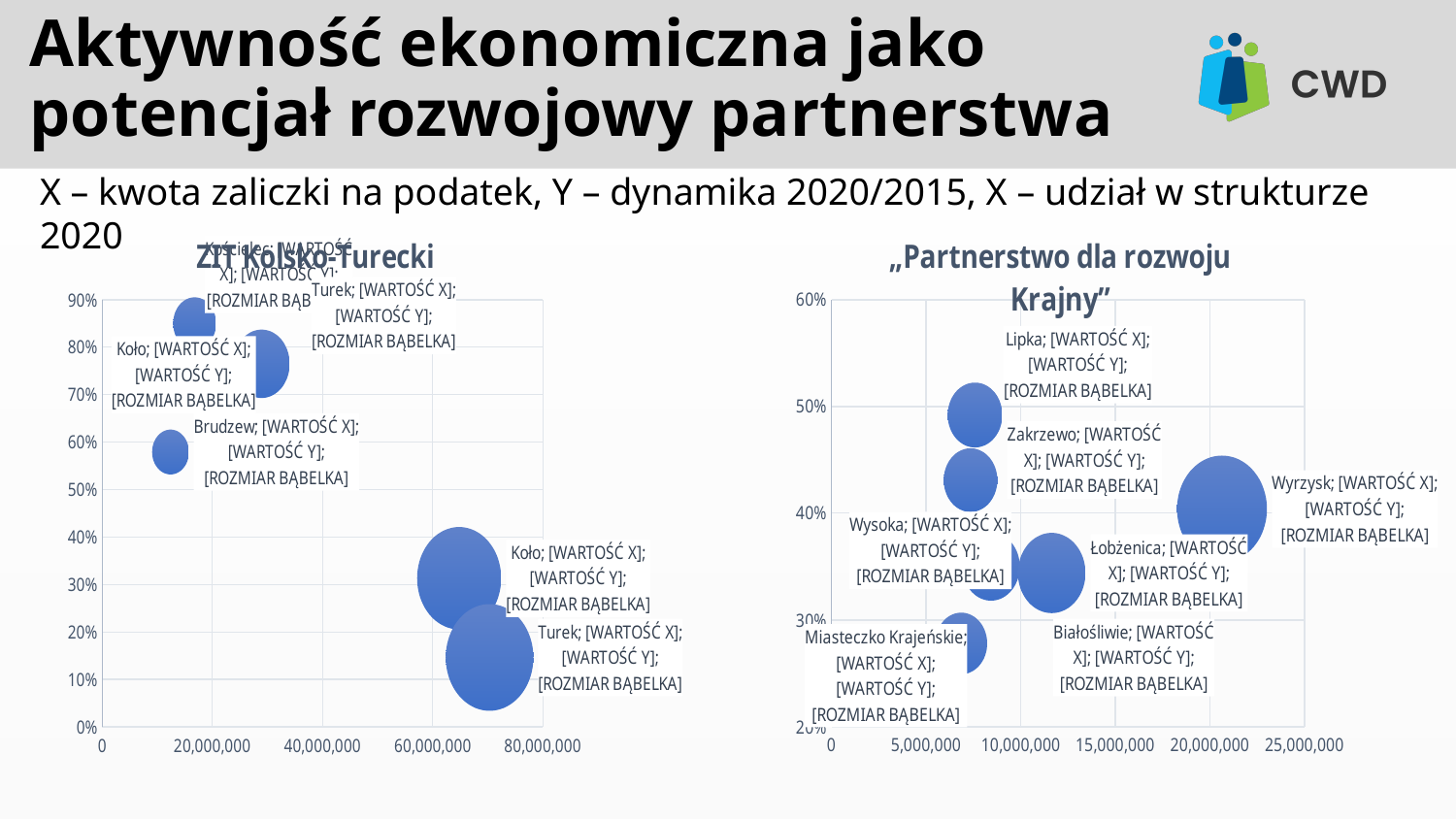
In the "Partnerstwo dla rozwoju Krajny" chart, which bubble has the highest Y value? Lipka In the "ZIT Kolsko-Turecki" chart, is the Y value for Brudzew greater or less than 50%? greater In the "Partnerstwo dla rozwoju Krajny" chart, which bubble has the largest X value? Wyrzysk What is the title of the chart on the right side of the slide? „Partnerstwo dla rozwoju Krajny” In the "ZIT Kolsko-Turecki" chart, is the Y value for the lower Turek bubble greater or less than 20%? less In the "Partnerstwo dla rozwoju Krajny" chart, is the Y value for Miasteczko Krajeńskie greater or less than 30%? less According to the slide text, what does the Y axis of the charts represent? dynamika 2020/2015 In the "ZIT Kolsko-Turecki" chart, which has the higher Y value, Brudzew or the lower Turek bubble? Brudzew What kind of chart is the "ZIT Kolsko-Turecki" chart? bubble chart